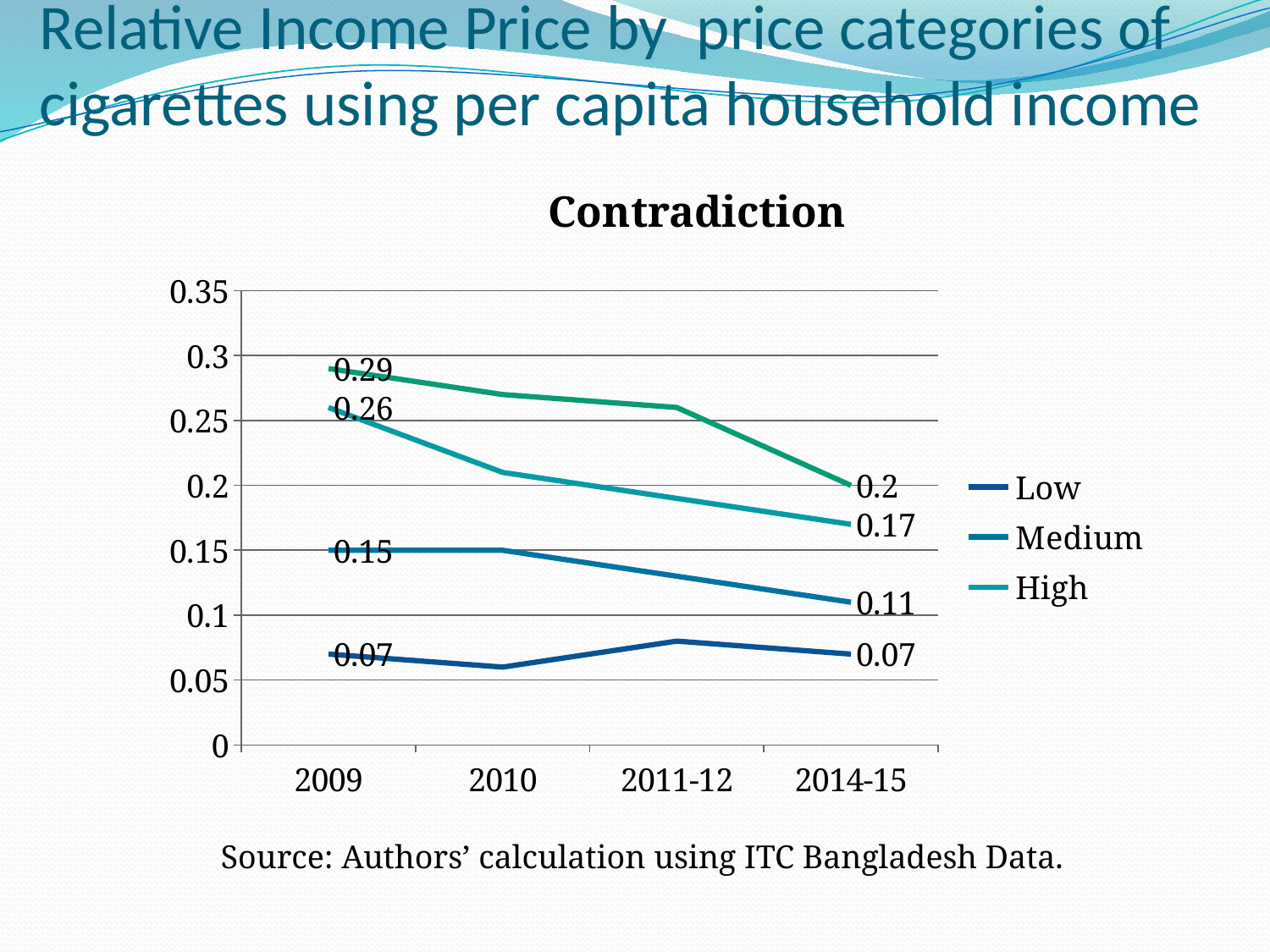
By how much did the High series fall from 2009 to 2014-15? 0.09 What is the value for the High series in 2014-15? 0.17 What kind of chart is shown on the slide? line chart Which series has the larger value in 2014-15, High or Medium? High What is the value for the Medium series in 2014-15? 0.11 What is the title of the chart? Contradiction What is the value for the High series in 2009? 0.26 How many series does the legend list? 3 What is the value for the Low series in 2009? 0.07 Is the value for the Medium series in 2011-12 greater or less than 0.15? less By how much did the Medium series fall from 2009 (0.15) to 2014-15 (0.11)? 0.04 How many time periods are shown on the x axis? 4